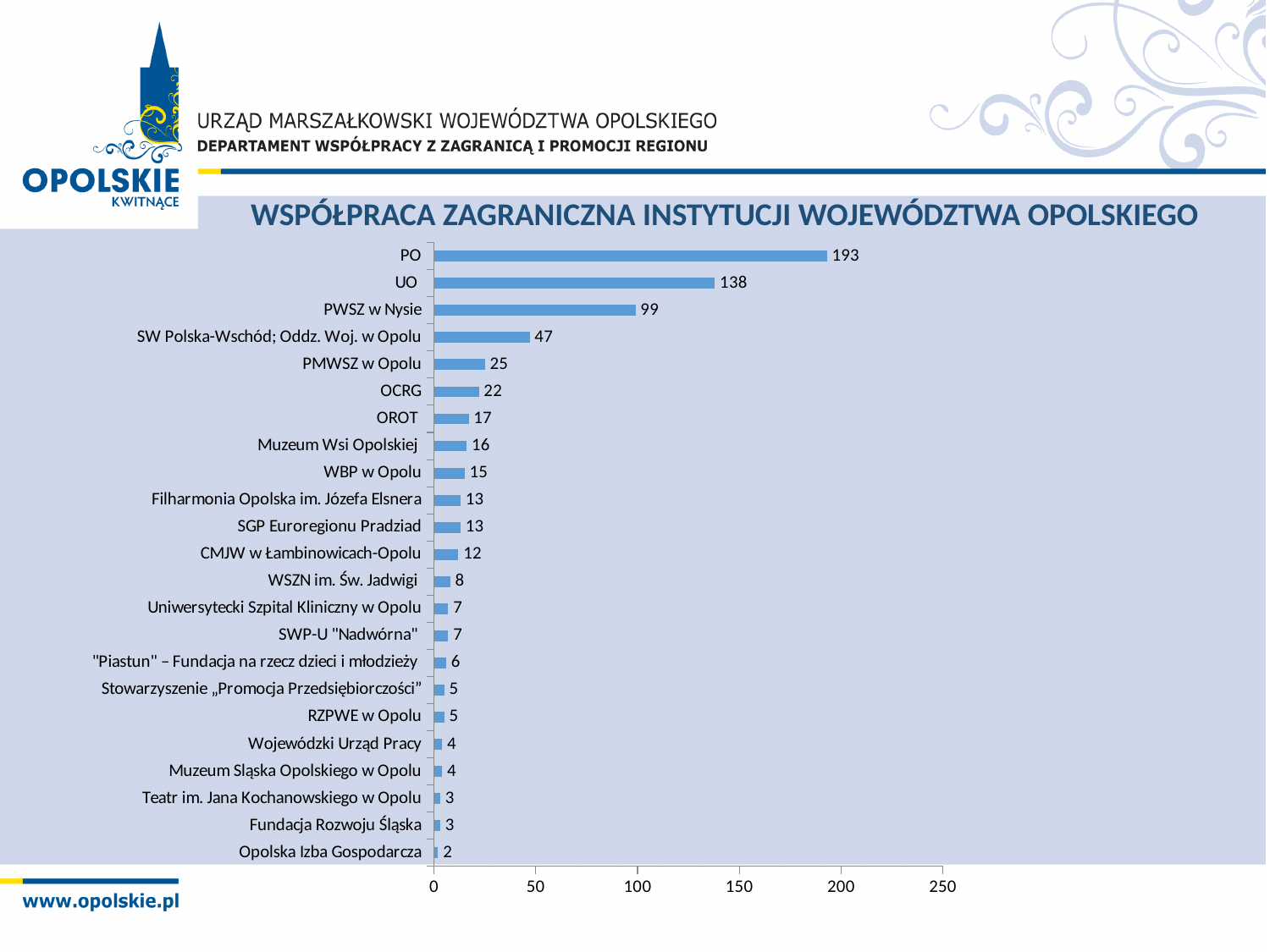
What is the difference between the values for PO and UO? 55 What is the title of the chart? WSPÓŁPRACA ZAGRANICZNA INSTYTUCJI WOJEWÓDZTWA OPOLSKIEGO How many categories are shown in the chart? 23 What is the value for PWSZ w Nysie? 99 What is the value for Muzeum Wsi Opolskiej? 16 Which is larger, the value for SW Polska-Wschód; Oddz. Woj. w Opolu or the value for PMWSZ w Opolu? SW Polska-Wschód; Oddz. Woj. w Opolu Which category has the lowest value? Opolska Izba Gospodarcza What is the value for PO? 193 Which category has the highest value? PO What is the value for OCRG? 22 What kind of chart is shown on the slide? bar chart Is the value for UO greater or less than 100? greater